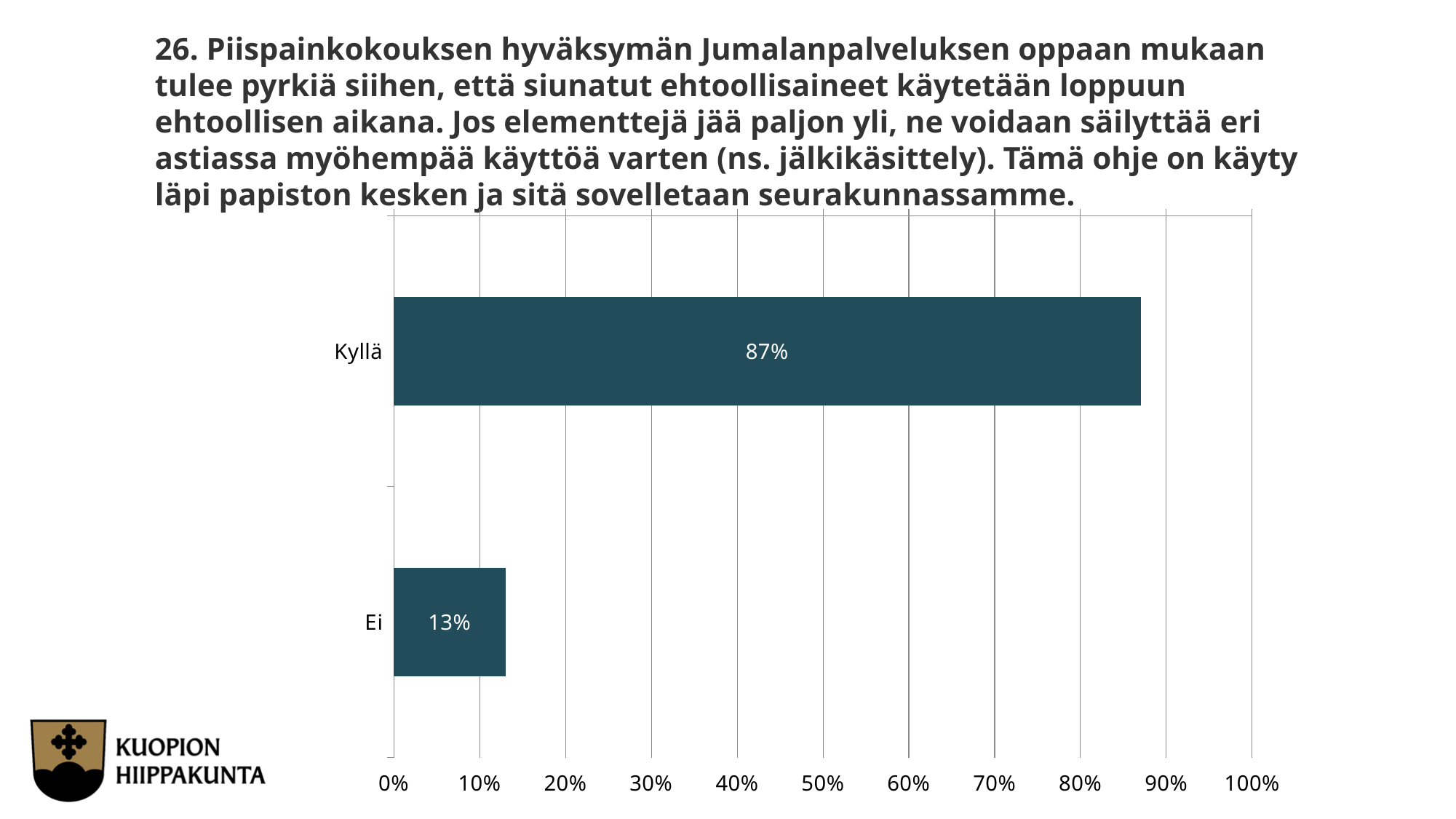
Which category has the lowest value? Ei How many categories are shown in the chart? 2 What kind of chart is shown on the slide? Bar chart What is the value for Kyllä? 87% Is the value for Ei greater or less than 20%? less Is the value for Kyllä greater or less than 80%? greater What is the total of the two bar values? 100% What is the maximum value shown on the horizontal axis? 100% What is the difference between the values for Kyllä and Ei? 74% Which category has the highest value? Kyllä What is the value for Ei? 13% Which is larger, the value for Kyllä or the value for Ei? Kyllä